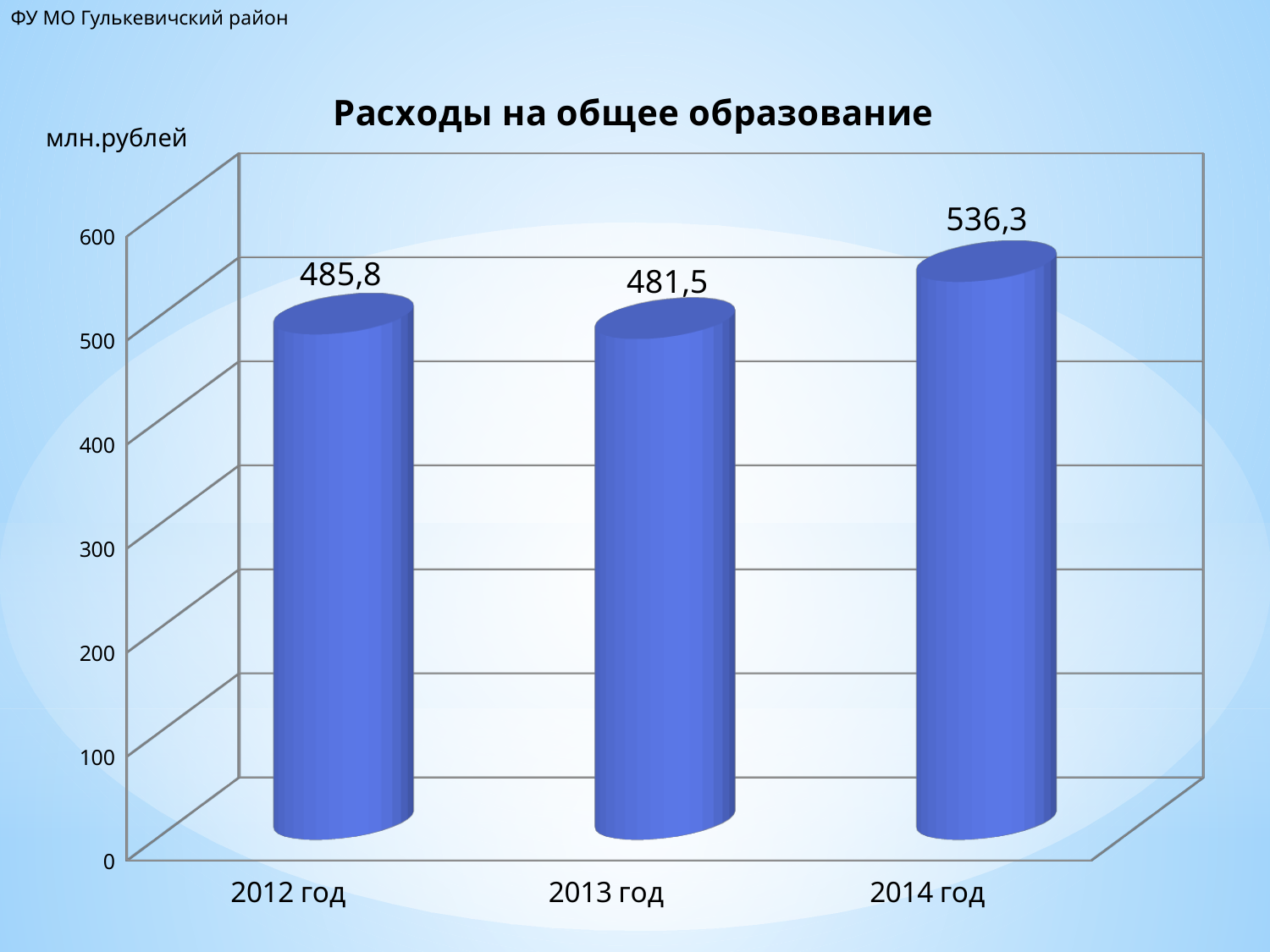
What is the value for 2013 год? 481,5 How many years are shown on the chart? 3 What is the difference between the values for 2014 год and 2013 год? 54,8 Which year has the highest value? 2014 год Which is larger, the value for 2014 год or the value for 2012 год? 2014 год What is the value for 2014 год? 536,3 Which year has the lowest value? 2013 год What kind of chart is this? bar chart What is the title of the chart? Расходы на общее образование What is the value for 2012 год? 485,8 Is the value for 2014 год greater or less than 500? greater What is the difference between the values for 2012 год and 2013 год? 4,3